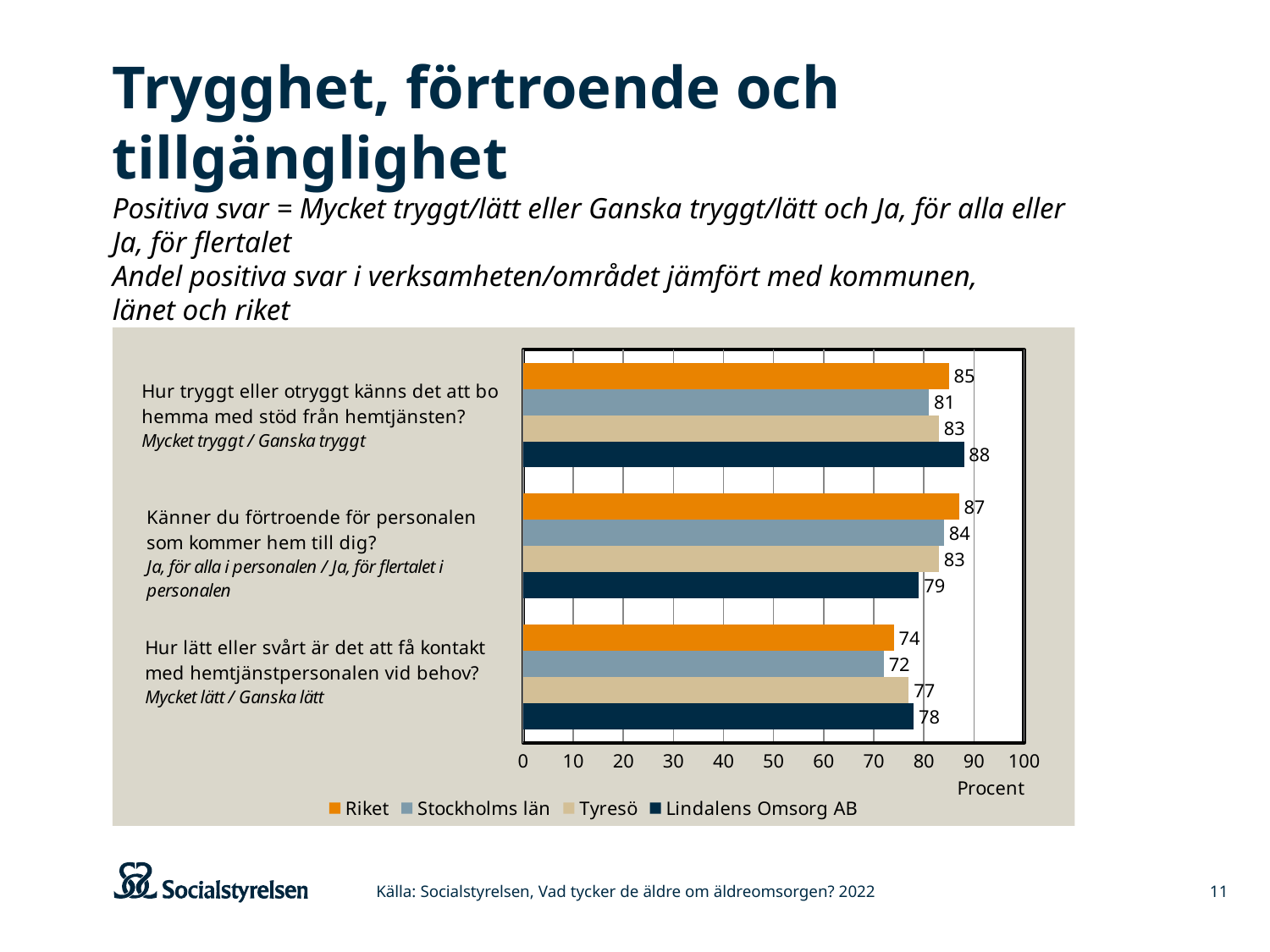
What is the value for Tyresö on the question "Hur lätt eller svårt är det att få kontakt med hemtjänstpersonalen vid behov?"? 77 Which series has the highest value on the question "Hur tryggt eller otryggt känns det att bo hemma med stöd från hemtjänsten?"? Lindalens Omsorg AB Which is larger on the question "Hur lätt eller svårt är det att få kontakt med hemtjänstpersonalen vid behov?": Riket or Tyresö? Tyresö What is the difference between Riket and Lindalens Omsorg AB on the question "Känner du förtroende för personalen som kommer hem till dig?"? 8 What is the label on the horizontal axis of the chart? Procent What is the value for Riket on the question "Känner du förtroende för personalen som kommer hem till dig?"? 87 How many question categories are shown on the chart? 3 Which series has the lowest value on the question "Känner du förtroende för personalen som kommer hem till dig?"? Lindalens Omsorg AB What is the value for Stockholms län on the question "Hur lätt eller svårt är det att få kontakt med hemtjänstpersonalen vid behov?"? 72 How many series does the legend list? 4 What kind of chart is shown on the slide? Bar chart What is the value for Lindalens Omsorg AB on the question "Hur tryggt eller otryggt känns det att bo hemma med stöd från hemtjänsten?"? 88